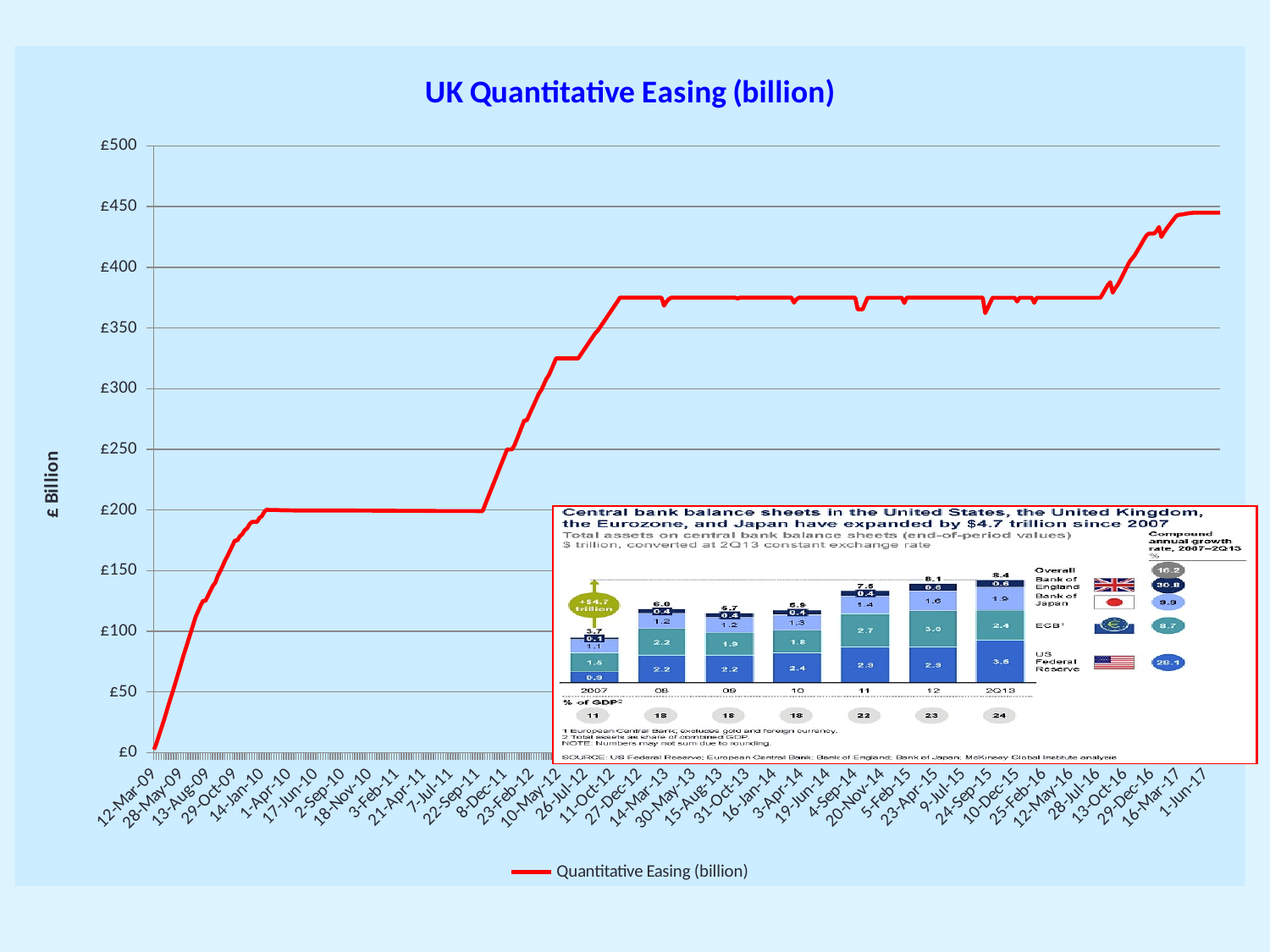
In the embedded 'Central bank balance sheets' stacked bar chart, which period has the highest total? 2Q13 In the main 'UK Quantitative Easing (billion)' chart, what is the label on the vertical axis? £ Billion What kind of chart is the main chart titled 'UK Quantitative Easing (billion)'? line chart In the embedded 'Central bank balance sheets' stacked bar chart, what is the difference between the 2Q13 total and the 2007 total? 4.7 In the main 'UK Quantitative Easing (billion)' chart, is the value at 14-Mar-13 greater or less than £350? greater In the main 'UK Quantitative Easing (billion)' chart, what colour is the plotted line? red In the main 'UK Quantitative Easing (billion)' chart, do the values generally rise or fall from 12-Mar-09 to 1-Jun-17? rise In the main 'UK Quantitative Easing (billion)' chart, is the value at 1-Jun-17 greater or less than £400? greater In the embedded 'Central bank balance sheets' stacked bar chart, what is the total for 2007? 3.7 In the main 'UK Quantitative Easing (billion)' chart, how many series does the legend list? 1 In the main 'UK Quantitative Easing (billion)' chart, is the value at 1-Apr-10 greater or less than £250? less In the main 'UK Quantitative Easing (billion)' chart, which is larger: the value at 12-Mar-09 or the value at 1-Jun-17? 1-Jun-17